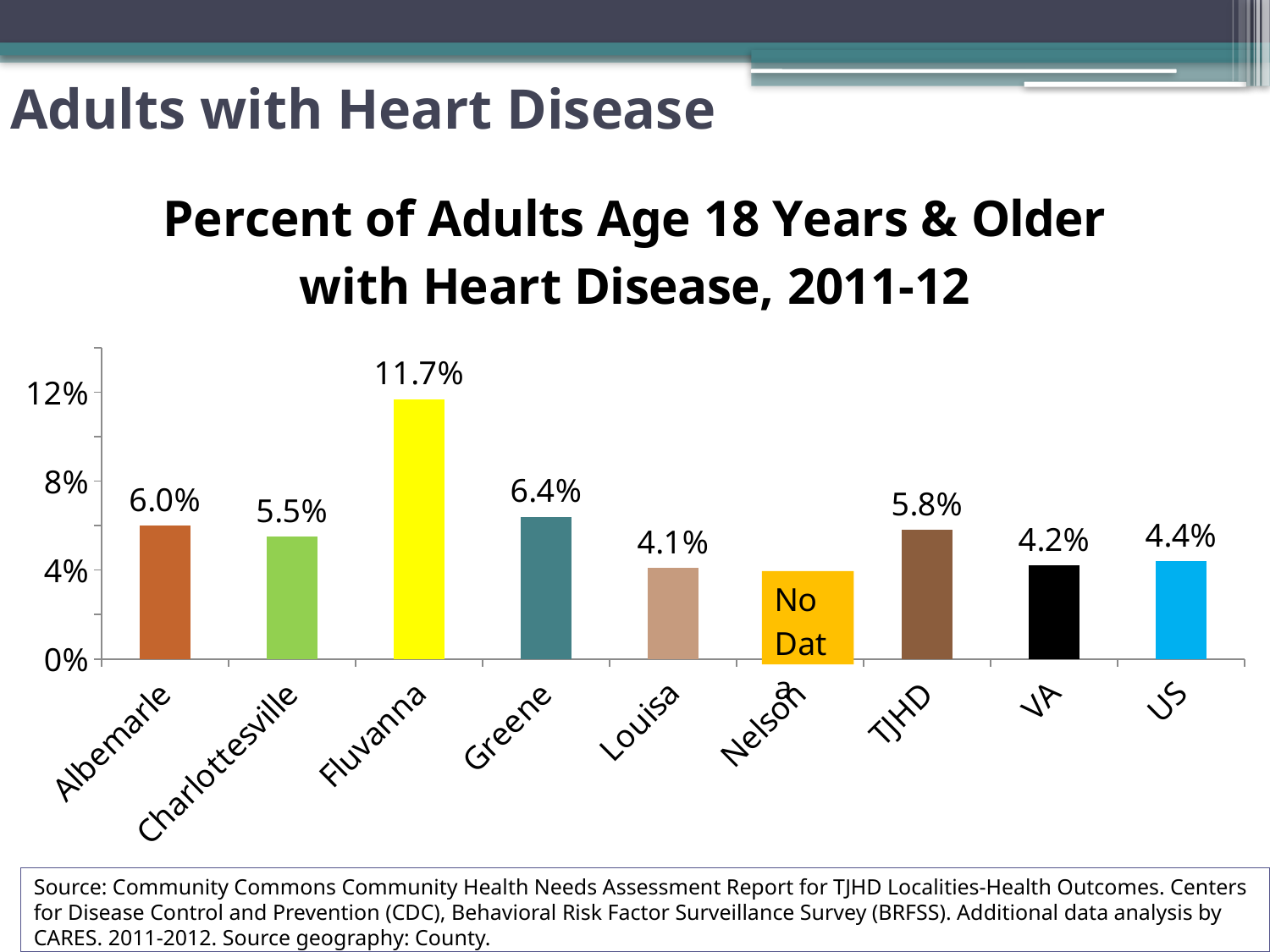
What is the value for TJHD? 5.8% How many categories are shown on the x axis? 9 What is the value for Charlottesville? 5.5% Is the value for Fluvanna greater or less than 8%? greater Among the categories with a printed value, which has the lowest percentage? Louisa What is the difference between the values for Fluvanna and Greene? 5.3% Which is larger, the value for Greene or the value for Albemarle? Greene What is the difference between the values for Albemarle and US? 1.6% What kind of chart is shown on the slide? Bar chart What is the value for Fluvanna? 11.7% Which locality has the highest percentage of adults with heart disease? Fluvanna What label is shown on the bar for Nelson instead of a value? No Data